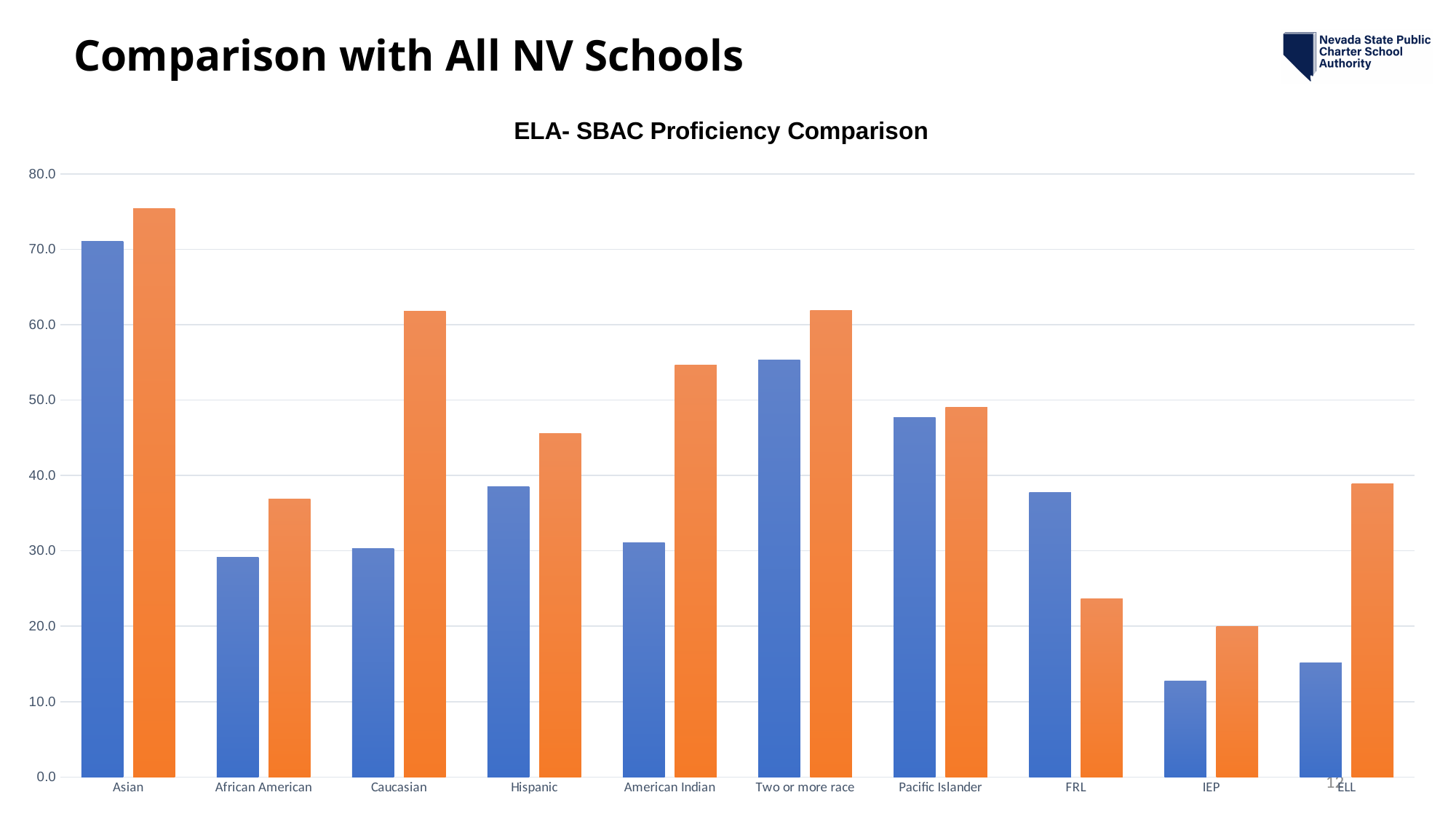
How many categories are shown on the x axis of the chart? 10 For FRL, which bar is taller, the blue bar or the orange bar? blue bar Is the value of the blue bar for Two or more race greater or less than 50.0? greater Is the value of the orange bar for Asian greater or less than 70.0? greater Is the value of the blue bar for IEP greater or less than 20.0? less For Caucasian, which bar is taller, the blue bar or the orange bar? orange bar Which category has the tallest blue bar? Asian Which category has the tallest orange bar? Asian Which category has the shortest orange bar? IEP What is the title of the chart? ELA- SBAC Proficiency Comparison What kind of chart is shown on the slide? bar chart Which category has the shortest blue bar? IEP